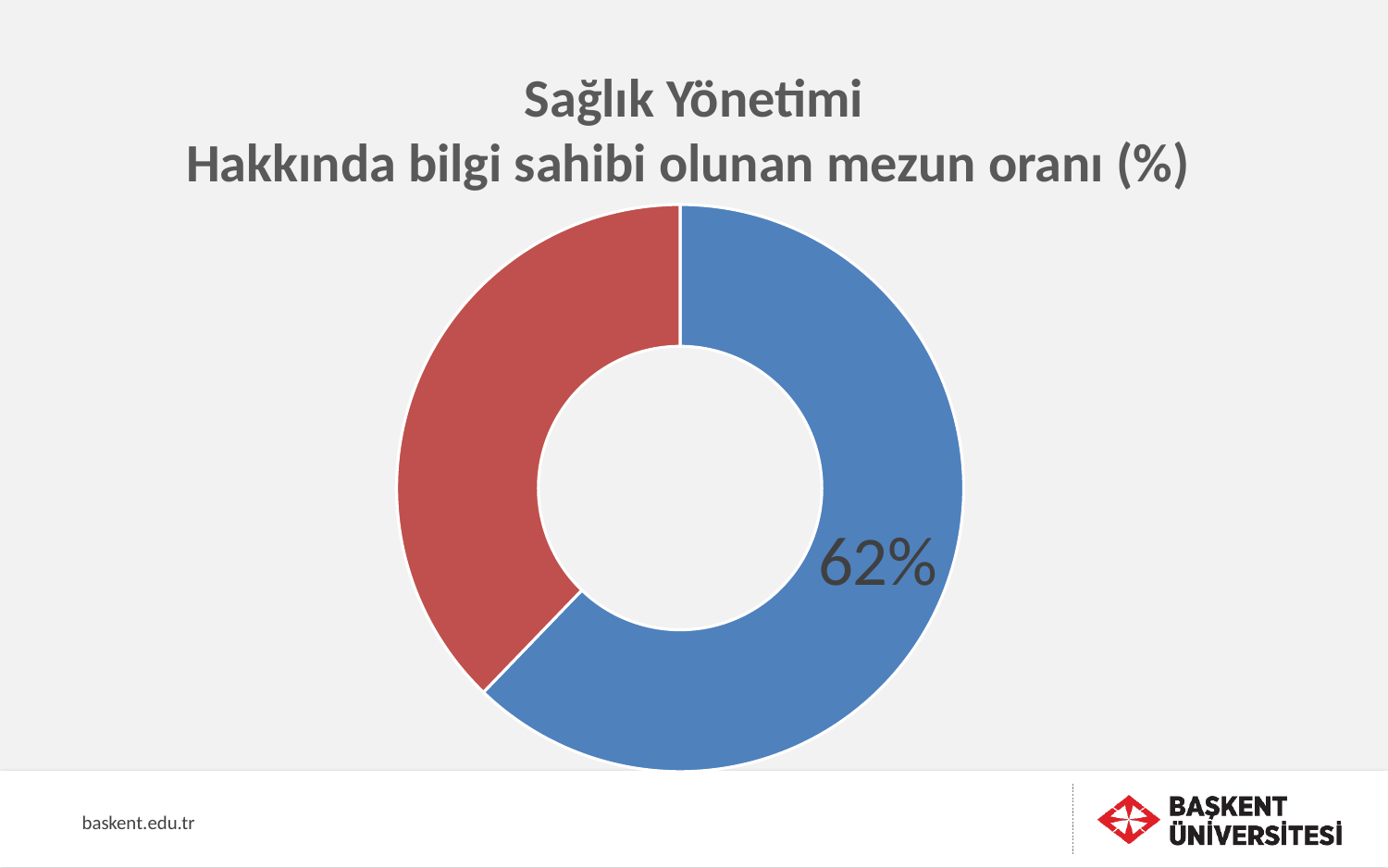
Which slice of the chart is the largest? The blue slice (62%) What is the title of the chart? Sağlık Yönetimi Hakkında bilgi sahibi olunan mezun oranı (%) What share of the doughnut does the blue slice represent? 62% Which slice of the chart is the smallest? The red slice Which slice is larger, the blue one or the red one? The blue one What colour is the slice that carries the 62% label? Blue What kind of chart is shown on the slide? Doughnut (pie) chart How many slices does the doughnut chart have? 2 What value is printed on the blue slice of the chart? 62%